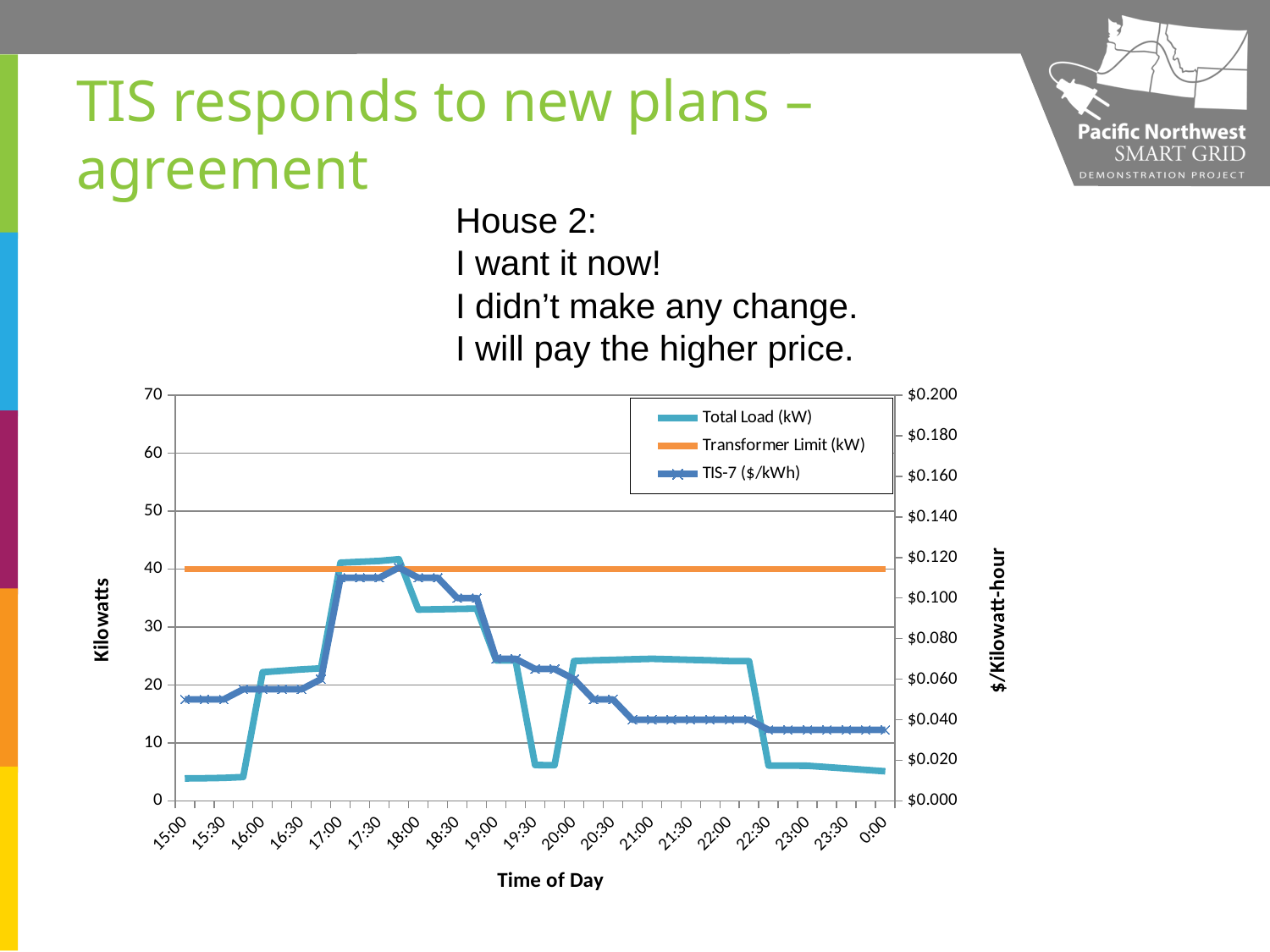
Is the Total Load (kW) value at 21:00 greater or less than 20? greater How many series does the chart legend list? 3 Is the Total Load (kW) value at 17:30 greater or less than 40? greater Is the TIS-7 ($/kWh) value at 17:30 greater or less than $0.100? greater What is the title of the x axis of the chart? Time of Day Which is larger at 17:00: the Total Load (kW) or the Total Load (kW) at 15:00? Total Load at 17:00 How many time labels are shown along the x axis of the chart? 19 Does the Total Load (kW) series rise or fall between 22:00 and 0:00? fall What kind of chart is shown on the slide? line chart What is the value of the Transformer Limit (kW) series? 40